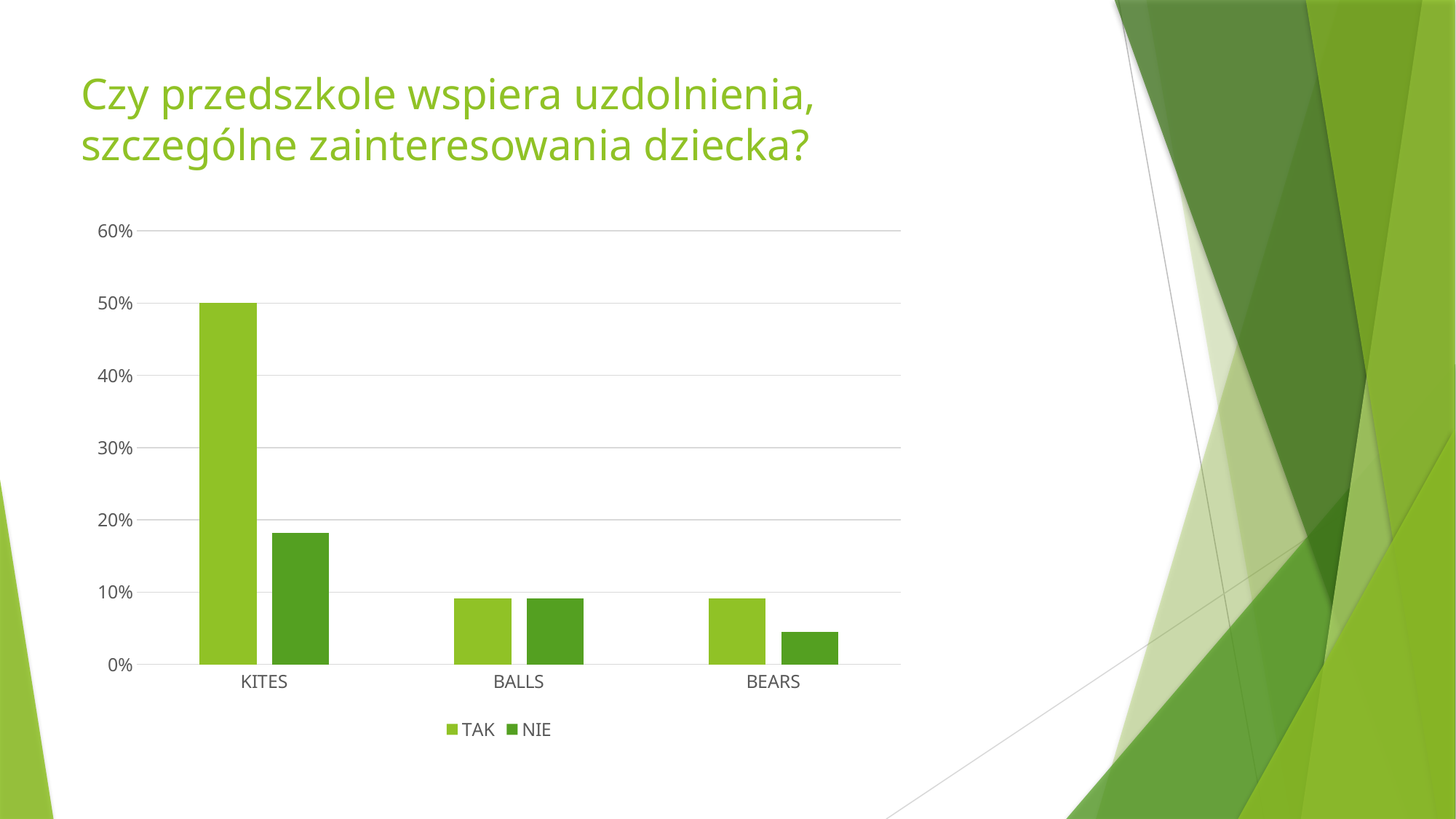
For BEARS, which is larger: the TAK value or the NIE value? TAK Which category has the lowest NIE value? BEARS How many series does the chart legend list? 2 How many categories are shown on the x axis of the chart? 3 Is the NIE value for KITES greater or less than 10%? greater What are the two series named in the chart legend? TAK and NIE Is the NIE value for KITES greater or less than 20%? less What kind of chart is shown on the slide? bar chart For KITES, which is larger: the TAK value or the NIE value? TAK What is the TAK value for KITES? 50% Which category has the highest TAK value? KITES